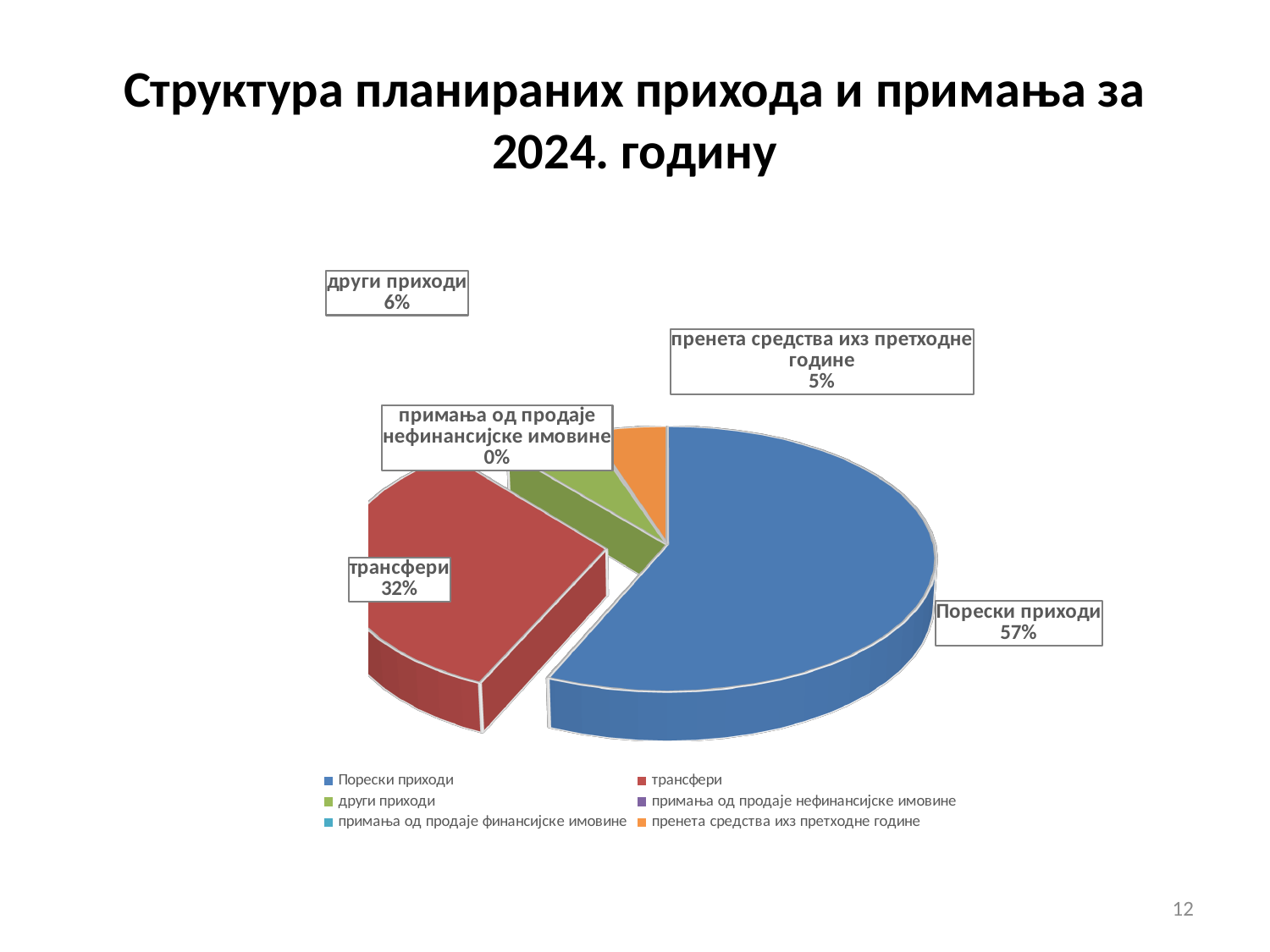
What share of the pie does други приходи represent? 6% What share of the pie does примања од продаје нефинансијске имовине represent? 0% What is the difference in percentage points between Порески приходи and трансфери? 25 What share of the pie does пренета средства ихз претходне године represent? 5% Which is larger, the share for други приходи or the share for пренета средства ихз претходне године? други приходи What is the title of the slide? Структура планираних прихода и примања за 2024. годину What colour is the slice for трансфери? red What kind of chart is shown on the slide? pie chart Which category has the largest share of the pie? Порески приходи How many entries does the legend list? 6